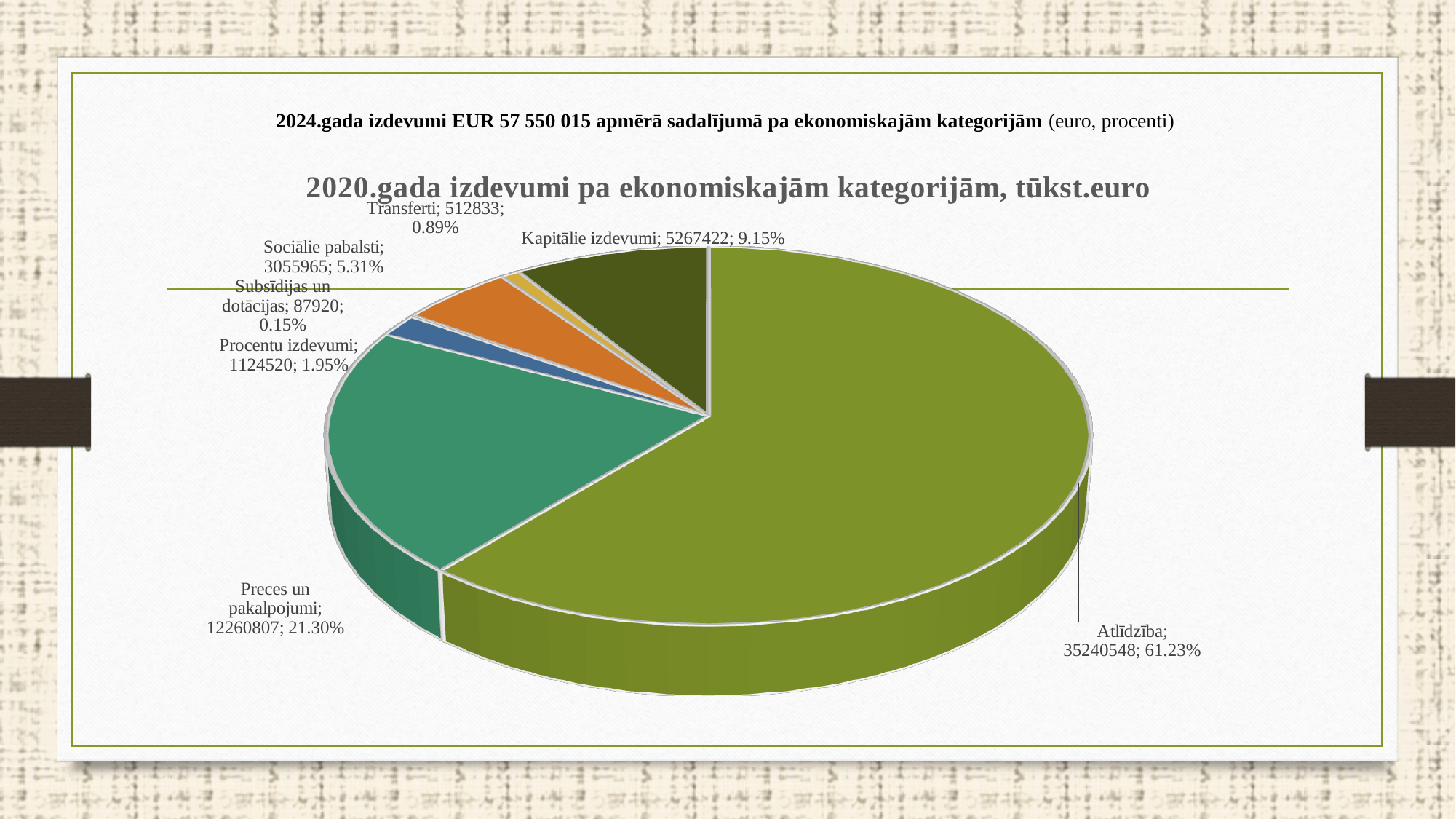
How many categories does the pie chart show? 7 What is the difference between the values for Kapitālie izdevumi and Sociālie pabalsti? 2211457 What is the value for Atlīdzība? 35240548 Which category has the largest slice of the pie? Atlīdzība What kind of chart is shown on the slide? pie chart What percentage is shown for Sociālie pabalsti? 5.31% What is the title of the pie chart? 2020.gada izdevumi pa ekonomiskajām kategorijām, tūkst.euro What is the value for Subsīdijas un dotācijas? 87920 Which is larger, Procentu izdevumi or Transferti? Procentu izdevumi What is the value for Kapitālie izdevumi? 5267422 What share of the pie does Preces un pakalpojumi represent? 21.30% Which category has the smallest slice of the pie? Subsīdijas un dotācijas